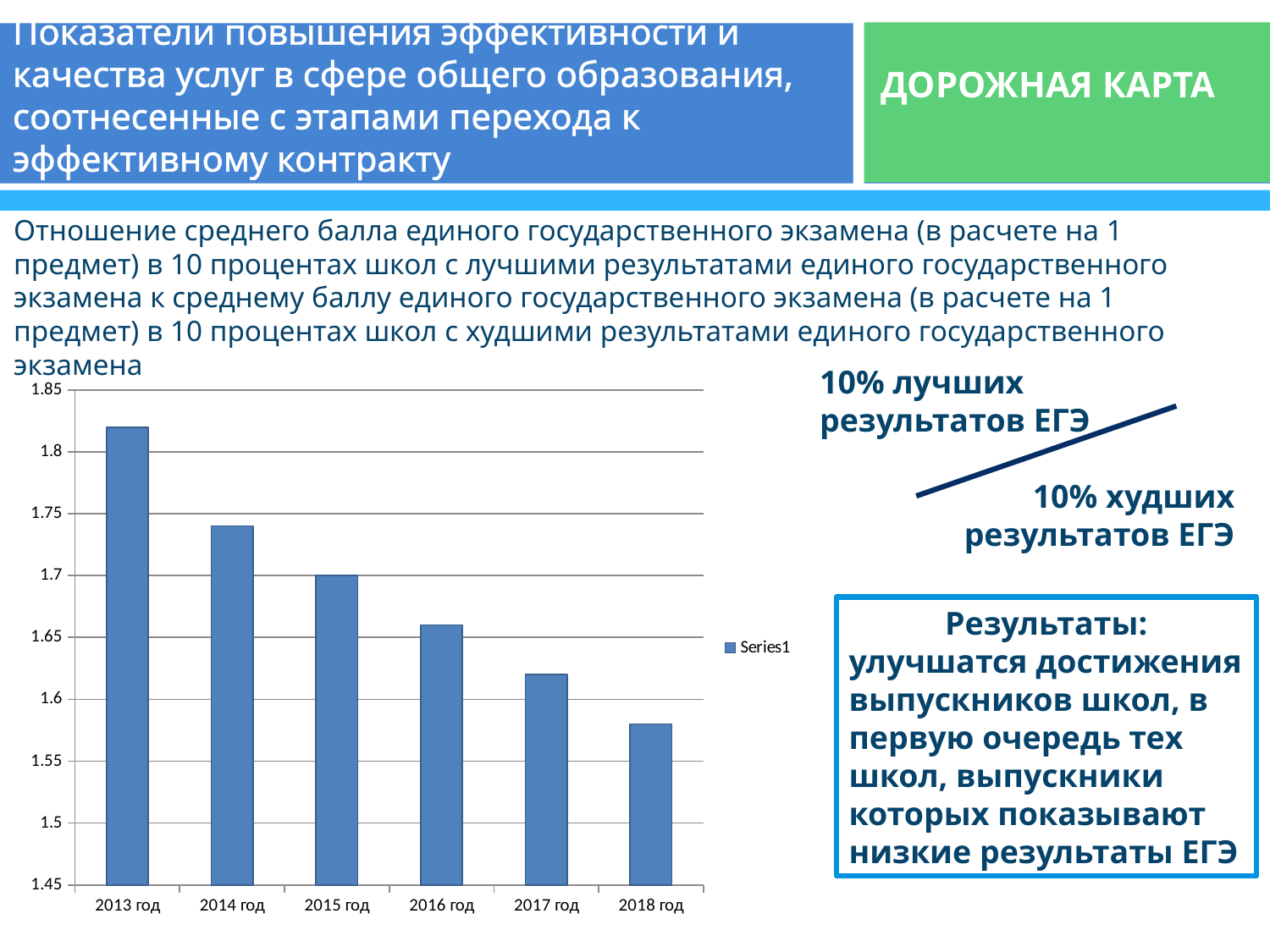
Which is larger, the value for 2014 год or the value for 2017 год? 2014 год How many categories (years) are shown on the x axis of the chart? 6 Do the values rise or fall from 2013 год to 2018 год? fall Which year has the lowest bar in the chart? 2018 год Which year has the highest bar in the chart? 2013 год Is the value for 2014 год greater or less than 1.75? less Is the value for 2013 год greater or less than 1.8? greater Is the value for 2018 год greater or less than 1.6? less How many series does the chart legend list? 1 What is the name of the series shown in the chart legend? Series1 What kind of chart is shown on the slide? bar chart